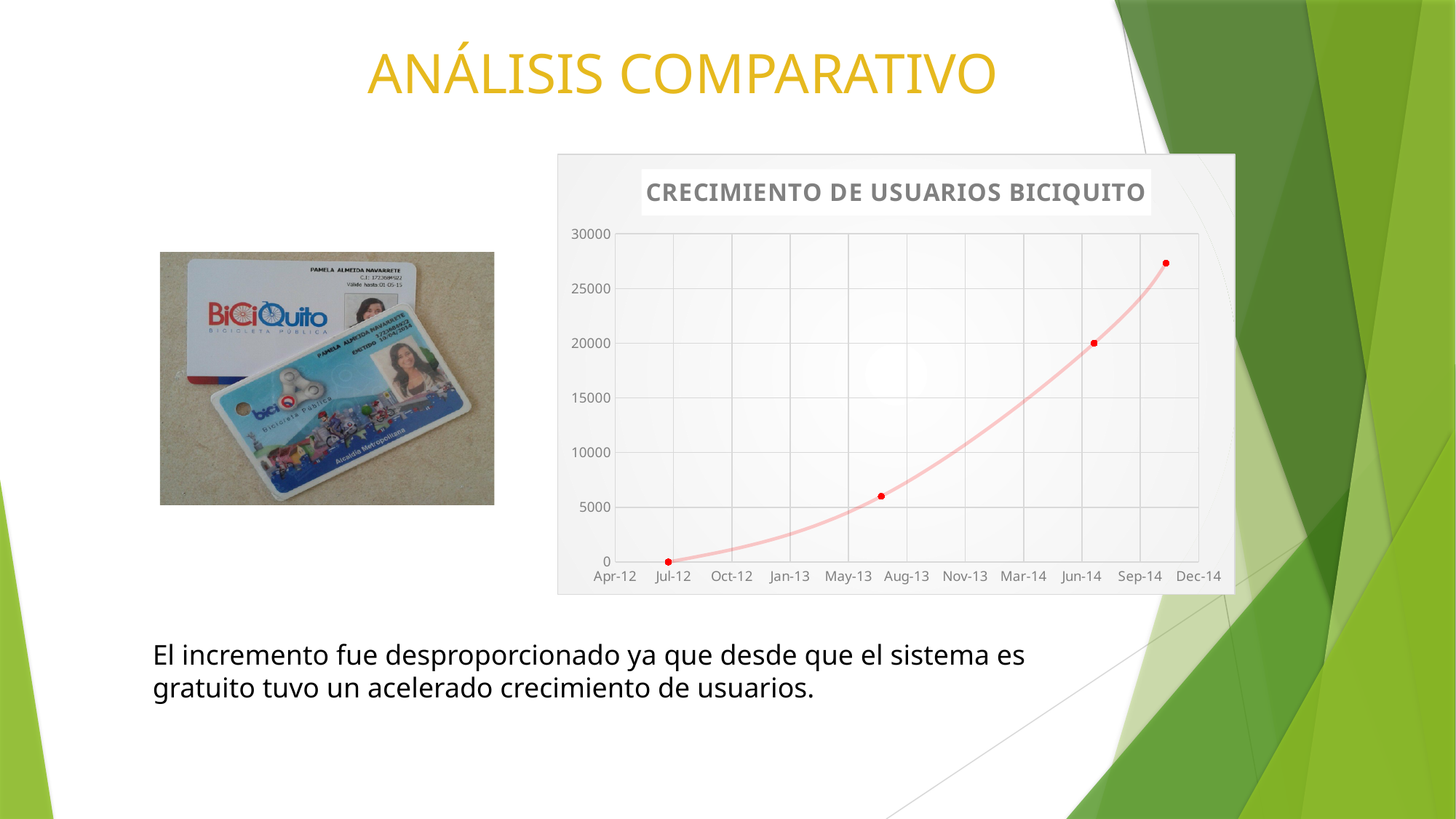
Is the value of the third plotted point (around Jun-14) greater or less than 15000? greater Is the value of the second plotted point (mid-2013) greater or less than 10000? less Is the value of the second plotted point (mid-2013) greater or less than 5000? greater What kind of chart is shown on the slide? scatter chart with a smooth line What is the title of the chart? CRECIMIENTO DE USUARIOS BICIQUITO Is the highest value at the beginning or the end of the series? end What is the value of the first plotted point, at Jul-12? 0 How many data points are plotted on the chart? 4 Do the values rise or fall from left to right along the x axis? rise Which is larger, the value of the first point (Jul-12) or the value of the last point (late 2014)? the last point What is the maximum value shown on the vertical axis? 30000